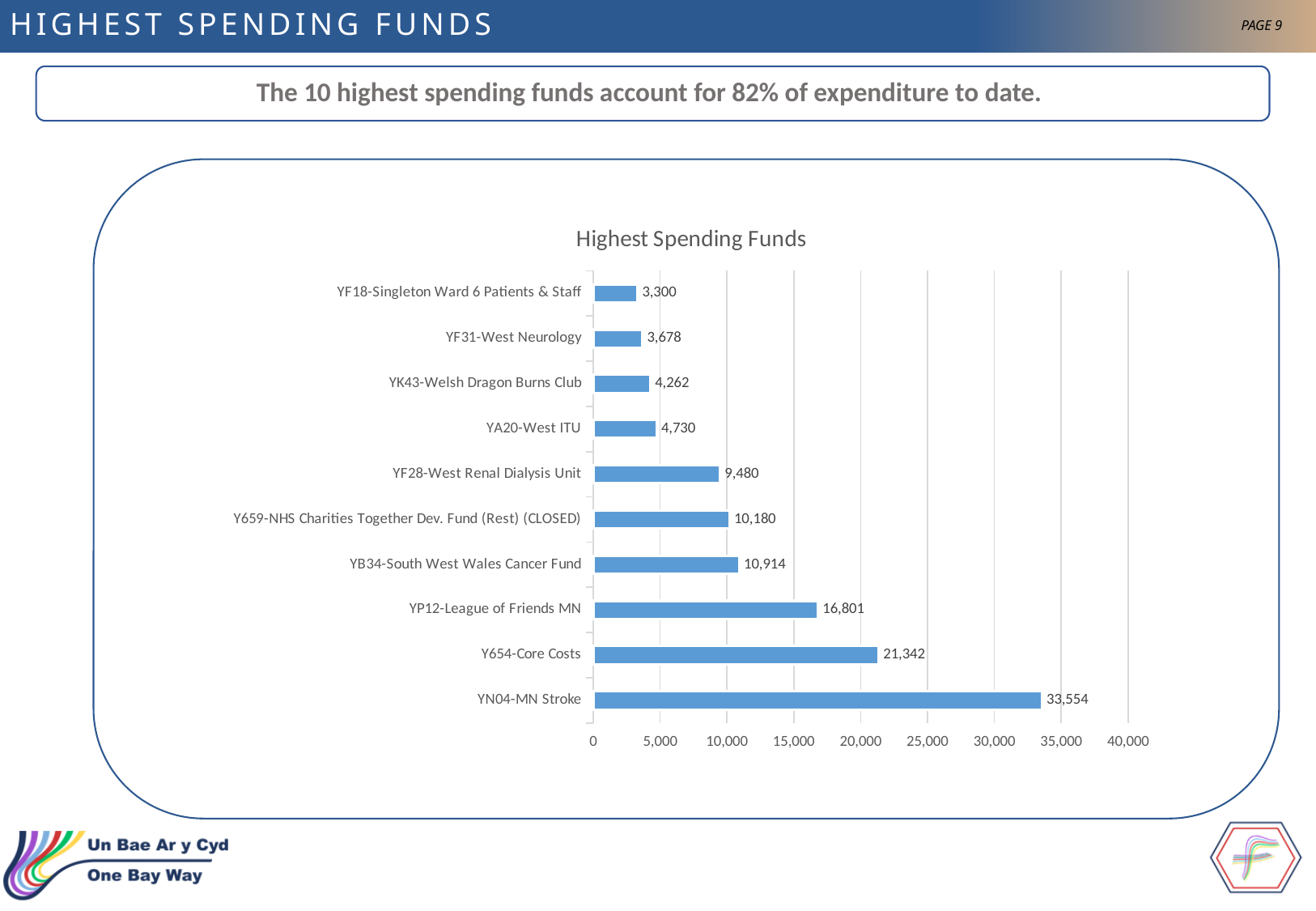
What is the value for YF31-West Neurology? 3,678 Which is larger, the value for YF28-West Renal Dialysis Unit or the value for YA20-West ITU? YF28-West Renal Dialysis Unit Is the value for Y659-NHS Charities Together Dev. Fund (Rest) (CLOSED) greater or less than 10,000? greater What is the difference between the values for YK43-Welsh Dragon Burns Club and YF18-Singleton Ward 6 Patients & Staff? 962 What is the value for YB34-South West Wales Cancer Fund? 10,914 What is the difference between the values for Y654-Core Costs and YP12-League of Friends MN? 4,541 What is the title of the chart? Highest Spending Funds What kind of chart is shown on the slide? bar chart What is the value for YN04-MN Stroke? 33,554 Which fund has the lowest spending? YF18-Singleton Ward 6 Patients & Staff Which fund has the highest spending? YN04-MN Stroke How many funds are shown in the chart? 10